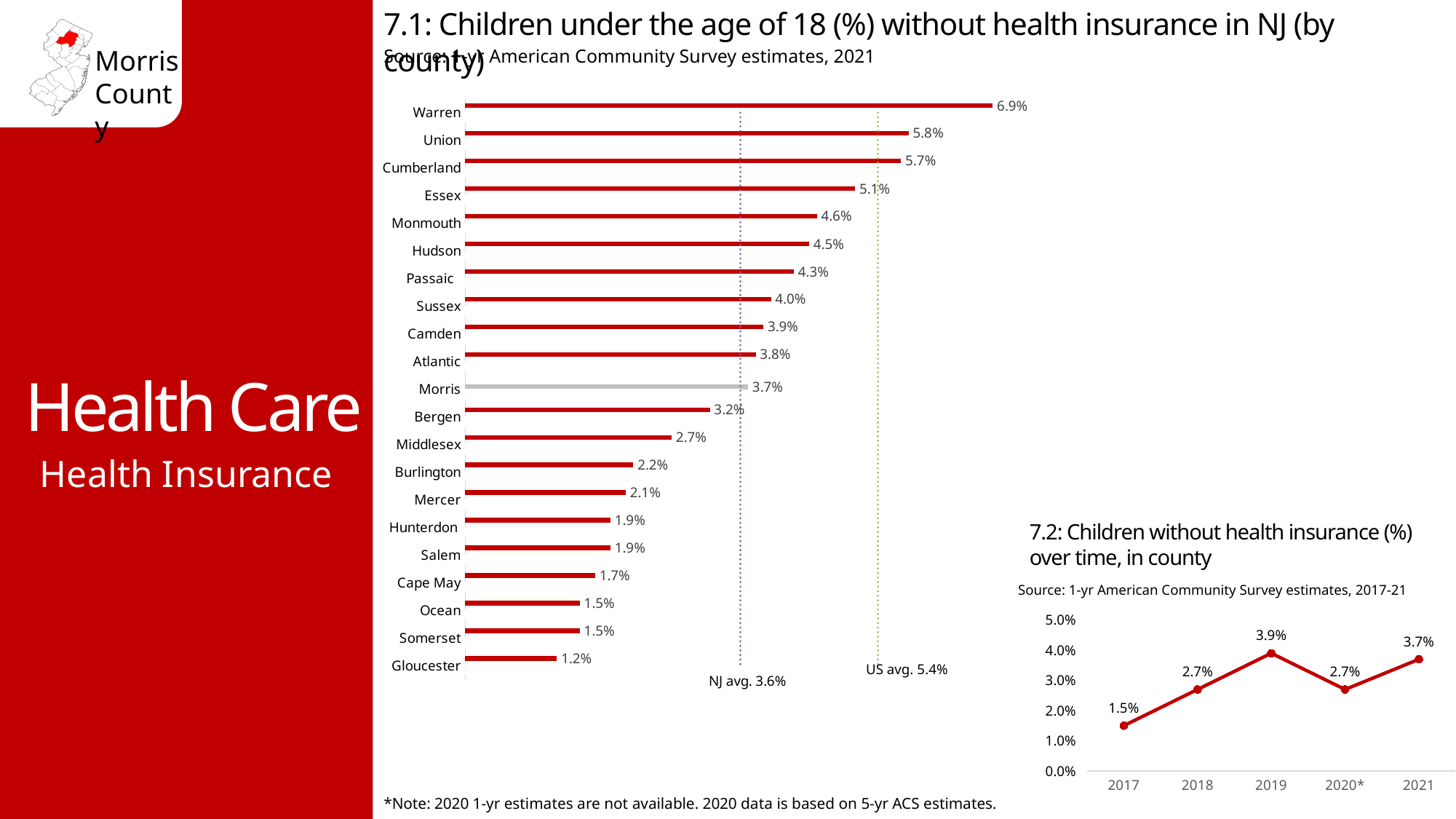
In chart 7.1, what NJ average is marked by the dotted reference line? 3.6% In chart 7.1, which county has the lowest percentage of children without health insurance? Gloucester In chart 7.1, which is larger, the value for Hudson or the value for Passaic? Hudson In chart 7.1, what is the difference between Warren and Gloucester? 5.7% In chart 7.1, how many counties are plotted? 21 In chart 7.1, what is the value for Cumberland? 5.7% In chart 7.2, what is the difference between the 2021 value and the 2017 value? 2.2% In chart 7.2 (children without health insurance over time), what is the value for 2019? 3.9% In chart 7.1, which county has the highest percentage of children without health insurance? Warren In chart 7.1 (children under 18 without health insurance by county), what is the value for Morris? 3.7% What kind of chart is chart 7.2? Line chart What kind of chart is chart 7.1? Bar chart